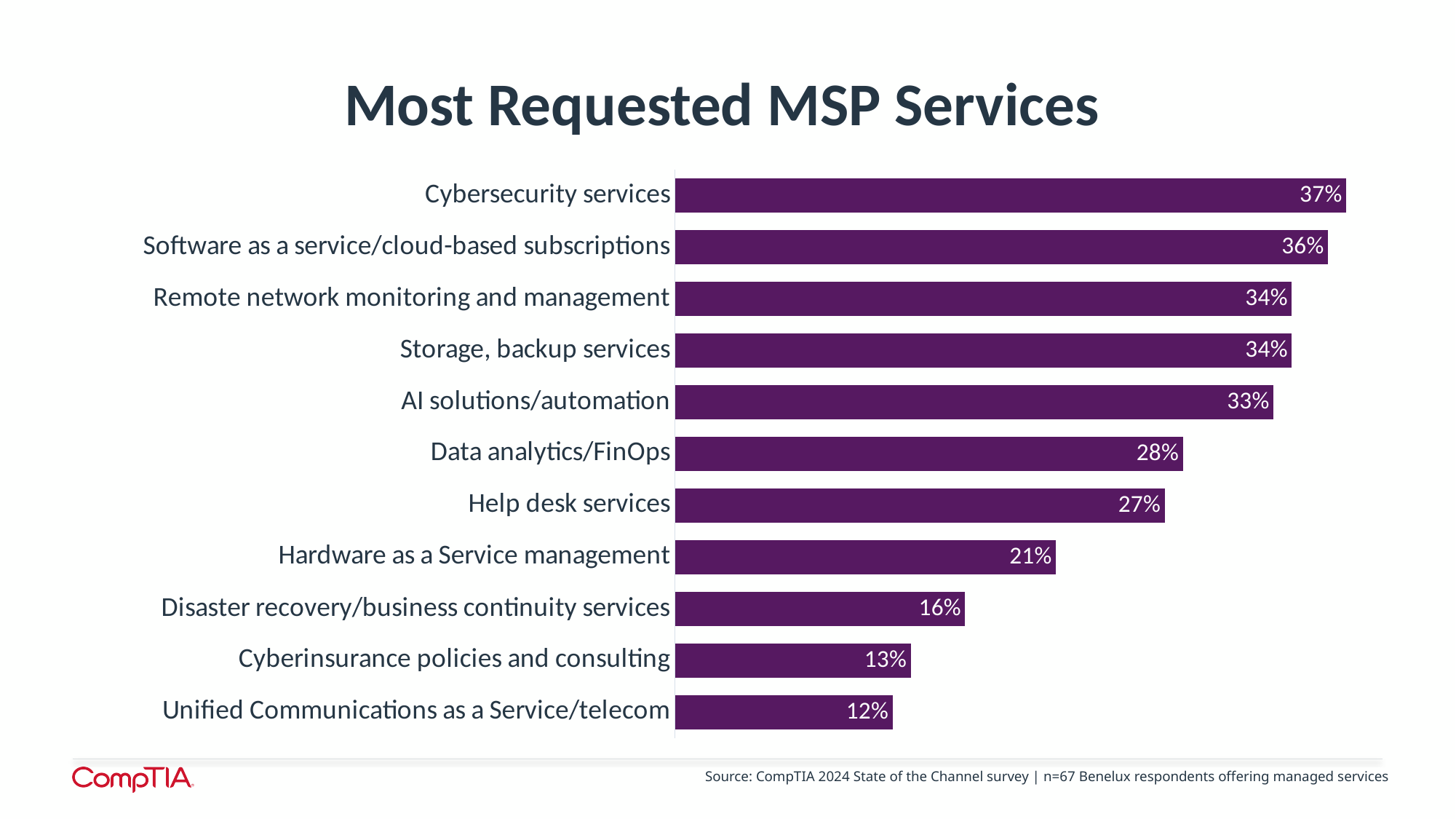
What is the title of the chart? Most Requested MSP Services What is the value for Disaster recovery/business continuity services? 16% Which service has the highest value? Cybersecurity services What is the difference between Data analytics/FinOps and Hardware as a Service management? 7% What is the difference between Cybersecurity services and Unified Communications as a Service/telecom? 25% Which is larger, Help desk services or Cyberinsurance policies and consulting? Help desk services What percentage is shown for Cybersecurity services? 37% How many services are listed in the chart? 11 What kind of chart is shown on the slide? Bar chart Which service has the lowest value? Unified Communications as a Service/telecom What is the value for AI solutions/automation? 33% What percentage is shown for Help desk services? 27%